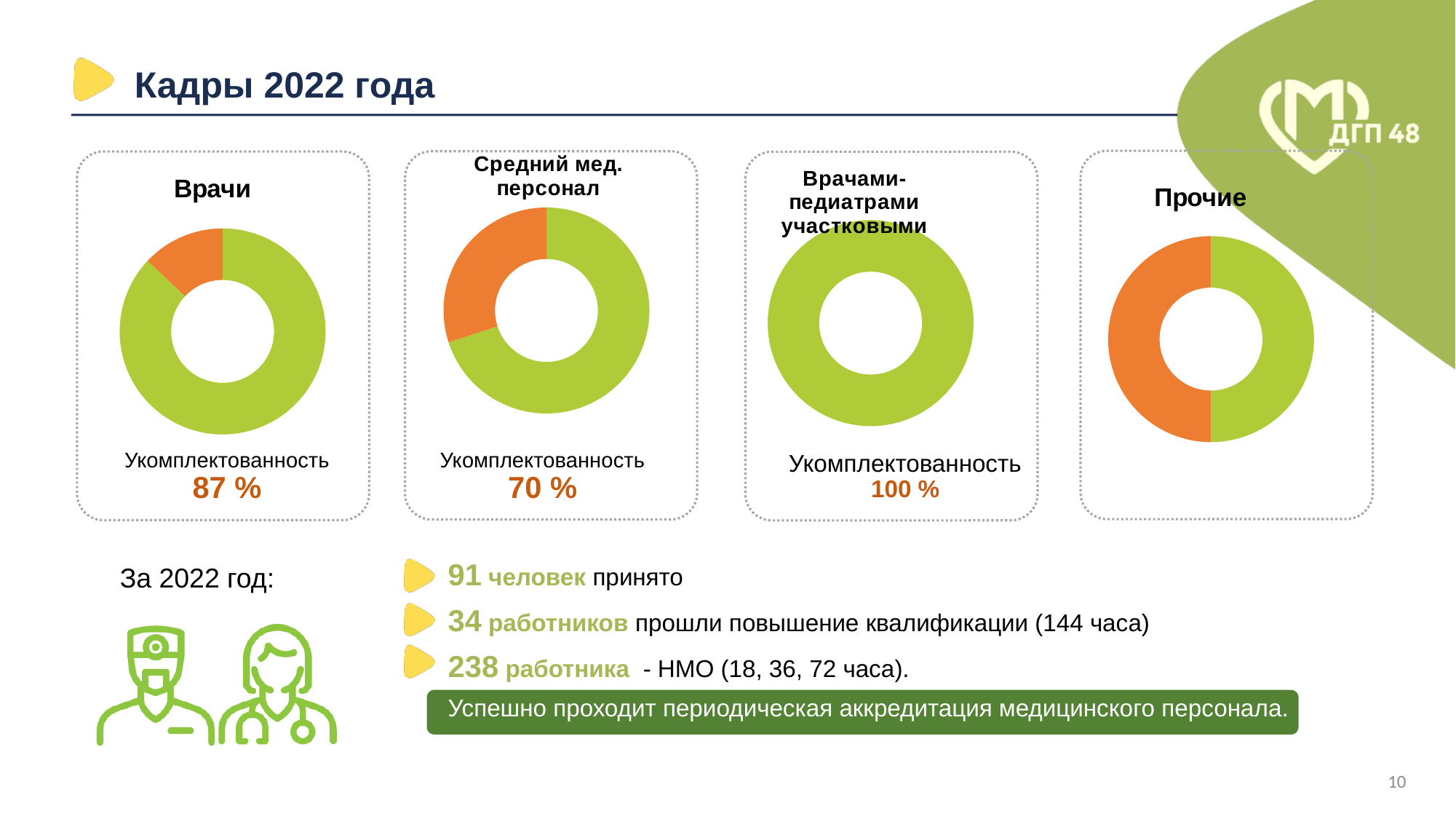
Which chart on the slide is entirely filled with green, with no orange segment? Врачами-педиатрами участковыми What is the staffing level (Укомплектованность) shown for the Врачи chart? 87 % Is the staffing level for Врачи greater or less than the staffing level for Врачами-педиатрами участковыми? less Which of the charts with a printed staffing value shows the highest staffing level? Врачами-педиатрами участковыми What is the difference between the staffing level for Врачами-педиатрами участковыми and for Врачи? 13 % Which has a lower staffing level: Врачи or Средний мед. персонал? Средний мед. персонал What is the difference between the staffing level for Врачи and for Средний мед. персонал? 17 % What is the staffing level shown for the Средний мед. персонал chart? 70 % What type of chart is used to show the staffing levels on the slide? Donut (pie) chart What is the staffing level shown for the Врачами-педиатрами участковыми chart? 100 % How many donut charts are shown on the slide? 4 What is the title of the slide containing the staffing charts? Кадры 2022 года